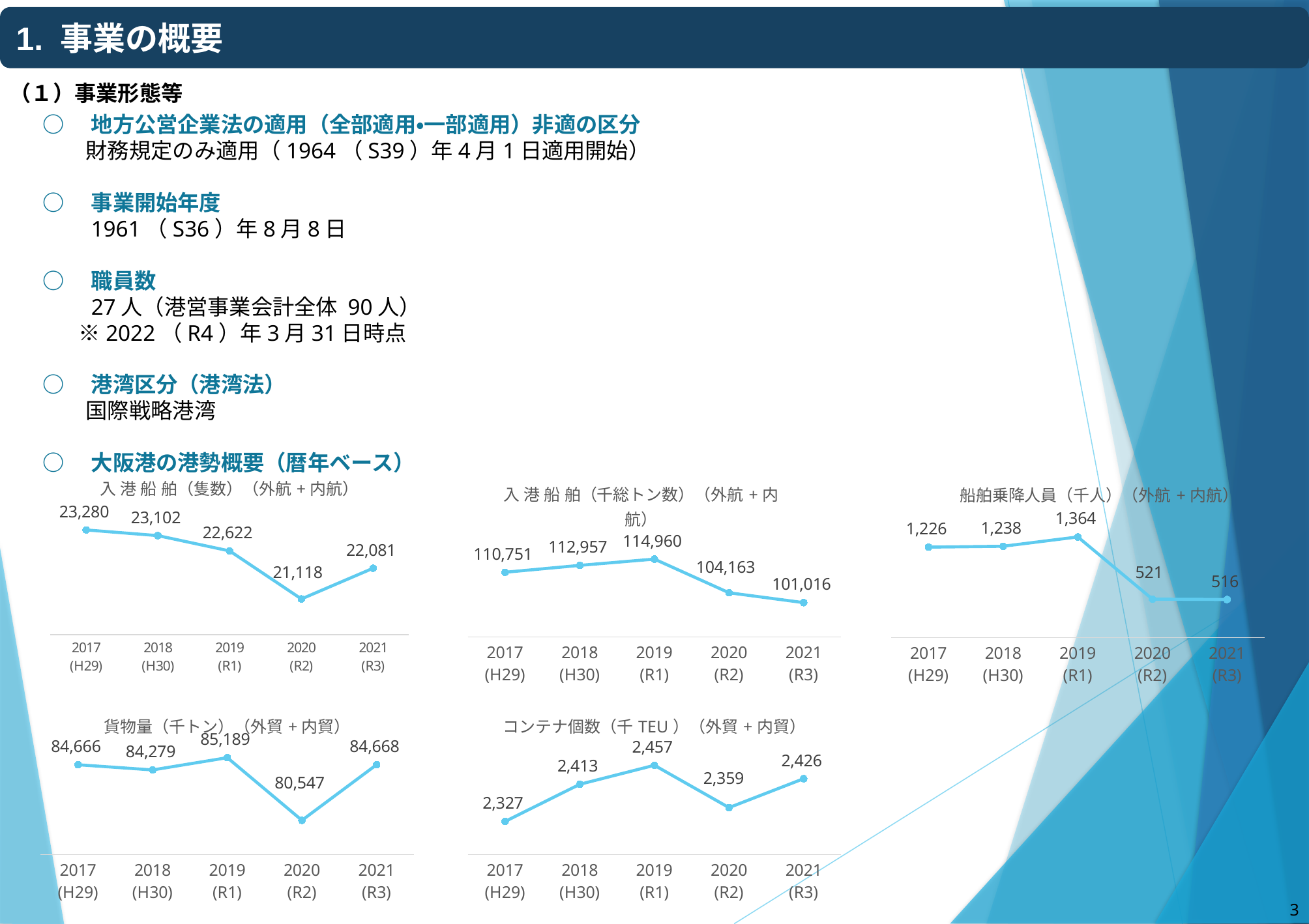
In the 貨物量（千トン） chart, what is the value for 2020 (R2)? 80,547 In the 入港船舶（千総トン数） chart, what is the value for 2019 (R1)? 114,960 In the コンテナ個数（千TEU） chart, what is the value for 2018 (H30)? 2,413 In the 入港船舶（千総トン数） chart, what is the difference between the 2019 (R1) and 2021 (R3) values? 13,944 How many years are plotted in the 貨物量（千トン） chart? 5 In the 船舶乗降人員（千人） chart, which year has the highest value? 2019 (R1) In the 入港船舶（隻数） chart, what is the value for 2021 (R3)? 22,081 What type of chart is the 船舶乗降人員（千人） chart? Line chart In the 入港船舶（隻数） chart, which year has the lowest value? 2020 (R2) In the コンテナ個数（千TEU） chart, what is the difference between the 2019 (R1) and 2017 (H29) values? 130 In the 貨物量（千トン） chart, which is larger, the value for 2017 (H29) or 2019 (R1)? 2019 (R1) In the 船舶乗降人員（千人） chart, what is the value for 2020 (R2)? 521